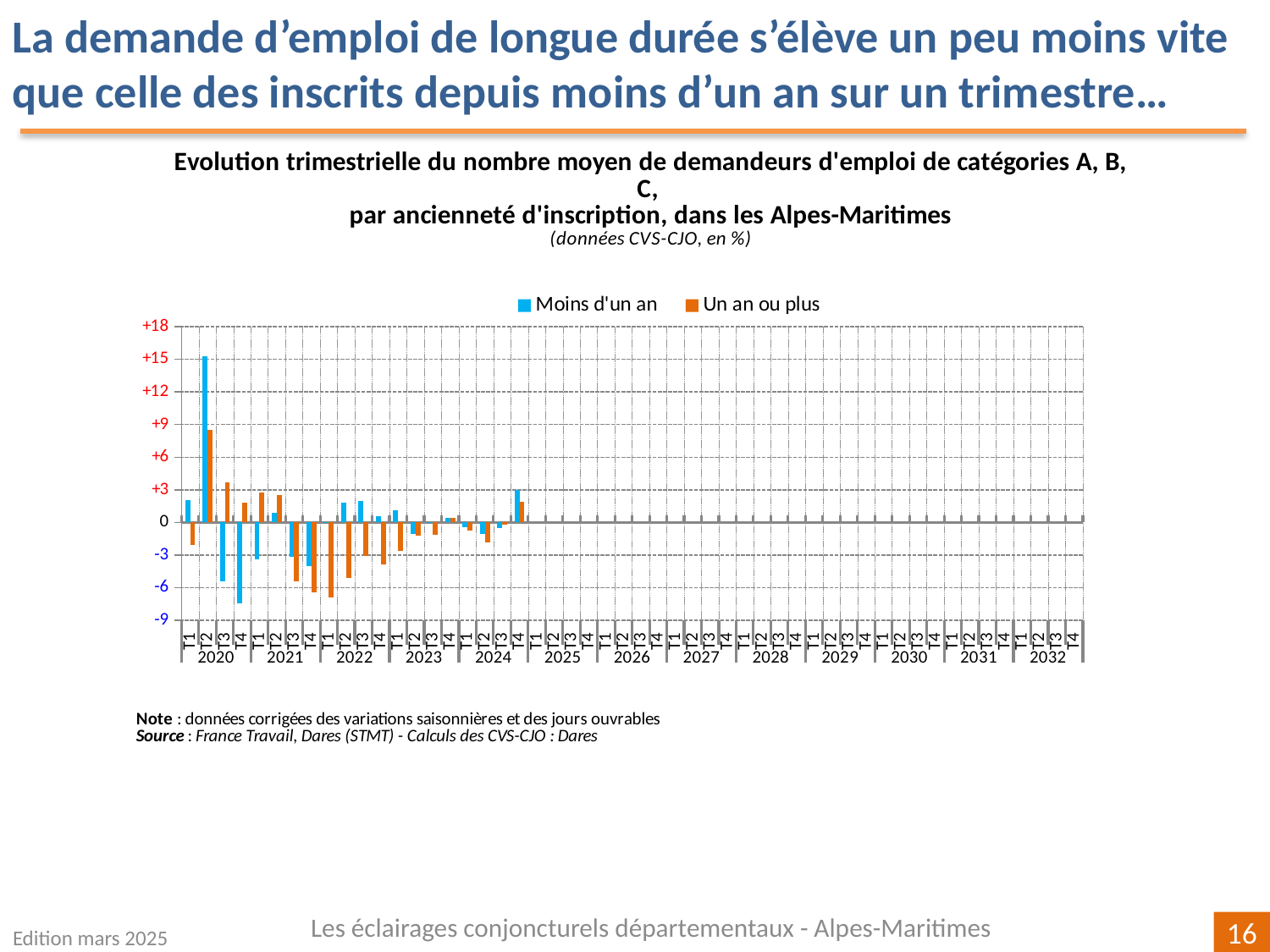
Which colour represents the series 'Un an ou plus'? orange How many years are labelled along the x axis? 13 Is the value for 'Moins d'un an' in T4 2020 greater or less than -6? less What kind of chart is shown on the slide? bar chart Is the value for 'Un an ou plus' in T2 2020 greater or less than +6? greater In which quarter does the series 'Un an ou plus' reach its highest value? T2 2020 Is the value for 'Moins d'un an' in T2 2020 greater or less than +12? greater How many series does the legend list? 2 What are the two series named in the legend? Moins d'un an; Un an ou plus In which quarter does the series 'Moins d'un an' reach its lowest value? T4 2020 In T3 2020, which series has the larger value, 'Moins d'un an' or 'Un an ou plus'? Un an ou plus In which quarter does the series 'Moins d'un an' reach its highest value? T2 2020